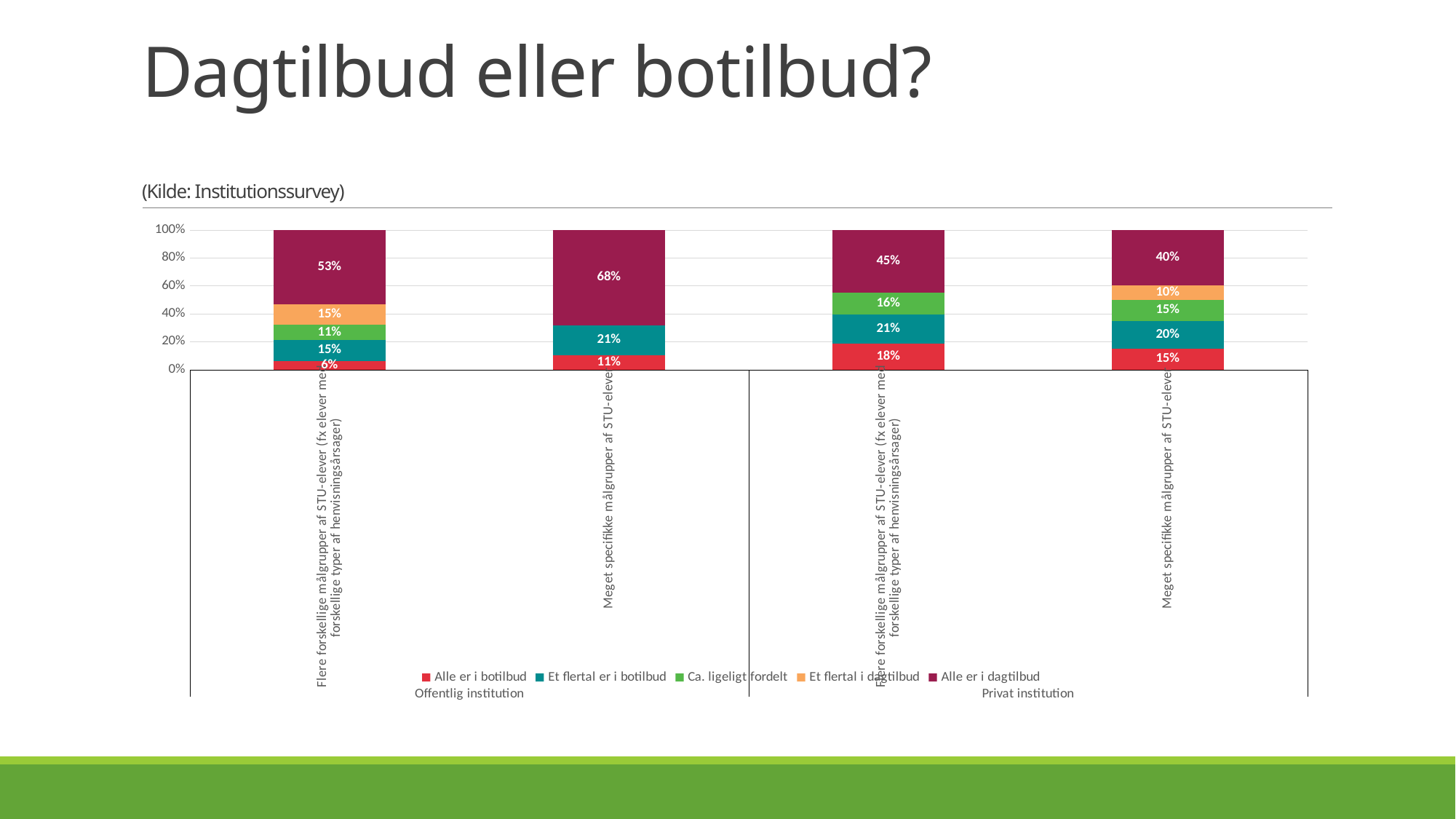
How many series does the legend list? 5 What kind of chart is shown on the slide? Stacked bar chart What is the value of 'Et flertal i dagtilbud' for 'Meget specifikke målgrupper af STU-elever' under Privat institution? 10% What is the value of 'Alle er i botilbud' for 'Flere forskellige målgrupper af STU-elever' under Offentlig institution? 6% What source is cited for the chart? Institutionssurvey How many bars are plotted in the chart? 4 Which bar has the lowest value for 'Alle er i botilbud'? Flere forskellige målgrupper af STU-elever (Offentlig institution) Which is larger: 'Alle er i botilbud' for 'Flere forskellige målgrupper af STU-elever' under Privat institution, or under Offentlig institution? Privat institution Which bar has the highest value for 'Alle er i dagtilbud'? Meget specifikke målgrupper af STU-elever (Offentlig institution) What is the difference between the 'Alle er i dagtilbud' values for 'Meget specifikke målgrupper af STU-elever' under Offentlig institution and under Privat institution? 28% What is the value of 'Alle er i dagtilbud' for 'Meget specifikke målgrupper af STU-elever' under Offentlig institution? 68% What is the value of 'Ca. ligeligt fordelt' for 'Flere forskellige målgrupper af STU-elever' under Privat institution? 16%